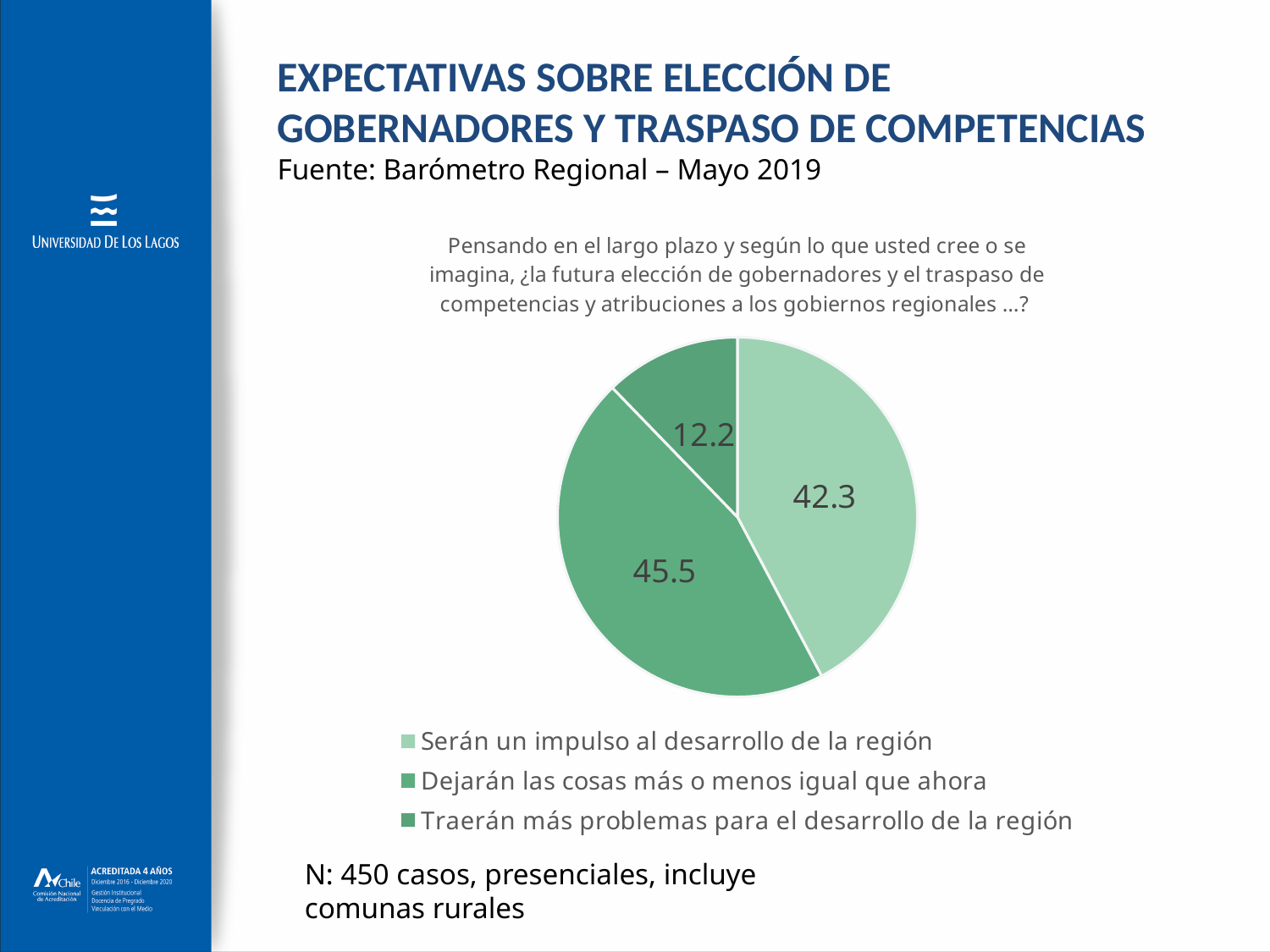
What is the difference between the values for "Serán un impulso al desarrollo de la región" and "Traerán más problemas para el desarrollo de la región"? 30.1 What is the value for "Traerán más problemas para el desarrollo de la región"? 12.2 What is the value for "Serán un impulso al desarrollo de la región"? 42.3 How many slices does the pie chart have? 3 What is the difference between the values for "Dejarán las cosas más o menos igual que ahora" and "Serán un impulso al desarrollo de la región"? 3.2 Which is larger: the value for "Serán un impulso al desarrollo de la región" or the value for "Traerán más problemas para el desarrollo de la región"? Serán un impulso al desarrollo de la región Which category has the smallest slice of the pie? Traerán más problemas para el desarrollo de la región What is the value for "Dejarán las cosas más o menos igual que ahora"? 45.5 What kind of chart is shown on the slide? pie chart How many entries does the legend list? 3 What is the source cited for the chart on the slide? Barómetro Regional – Mayo 2019 Which category has the largest slice of the pie? Dejarán las cosas más o menos igual que ahora